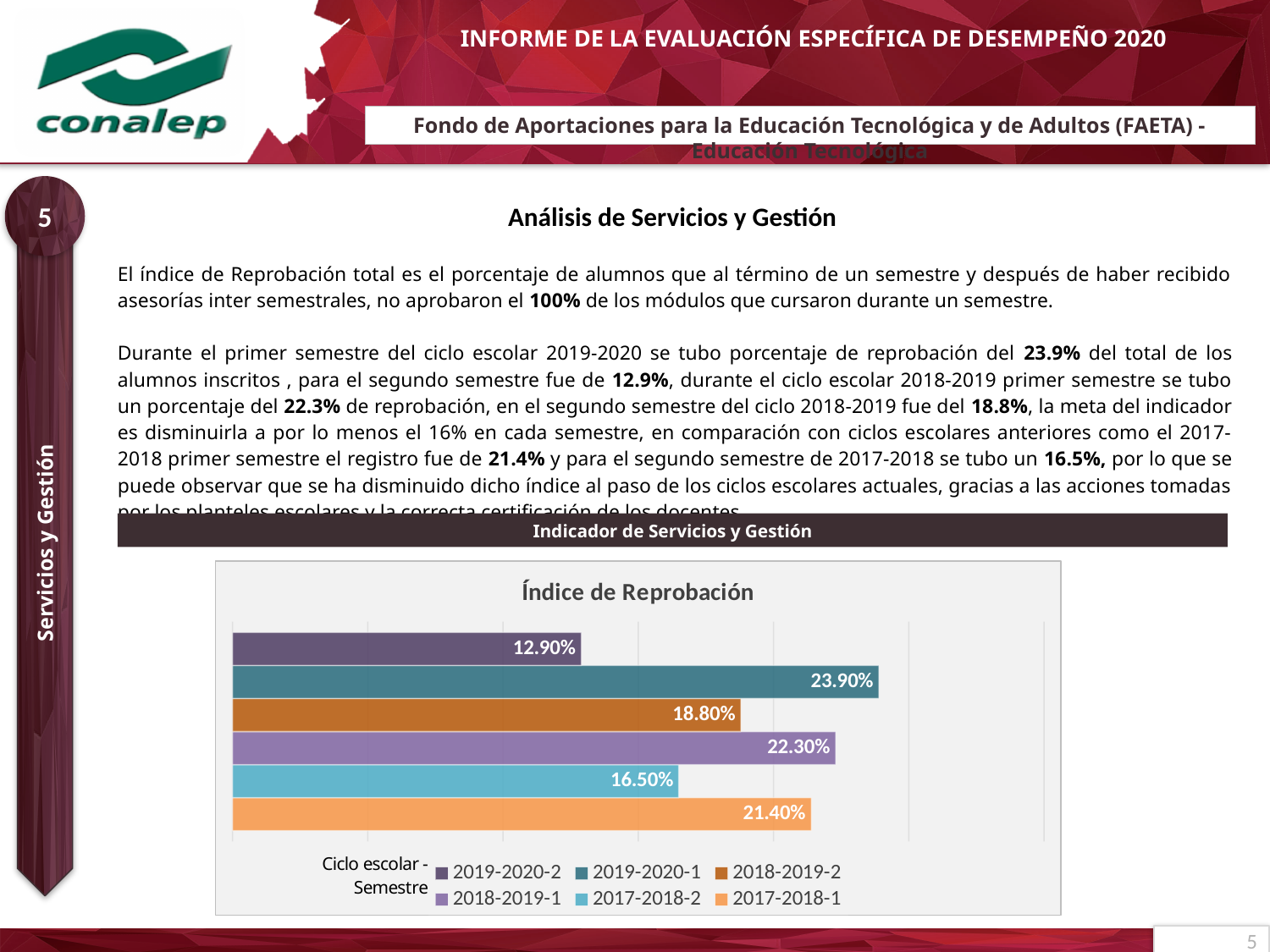
What is the value for 2018-2019-2 in the Índice de Reprobación chart? 18.80% Which is larger in the Índice de Reprobación chart, 2017-2018-1 or 2017-2018-2? 2017-2018-1 Which ciclo escolar-semestre has the lowest Índice de Reprobación? 2019-2020-2 How many entries does the legend of the Índice de Reprobación chart list? 6 What is the value for 2017-2018-1 in the Índice de Reprobación chart? 21.40% What is the difference between the Índice de Reprobación for 2019-2020-1 and 2019-2020-2? 11.00% Which ciclo escolar-semestre has the highest Índice de Reprobación? 2019-2020-1 How many bars are shown in the Índice de Reprobación chart? 6 What is the value for 2019-2020-2 in the Índice de Reprobación chart? 12.90% What is the difference between the Índice de Reprobación for 2018-2019-1 and 2018-2019-2? 3.50% What type of chart is the Índice de Reprobación chart? Bar chart What is the value for 2019-2020-1 in the Índice de Reprobación chart? 23.90%